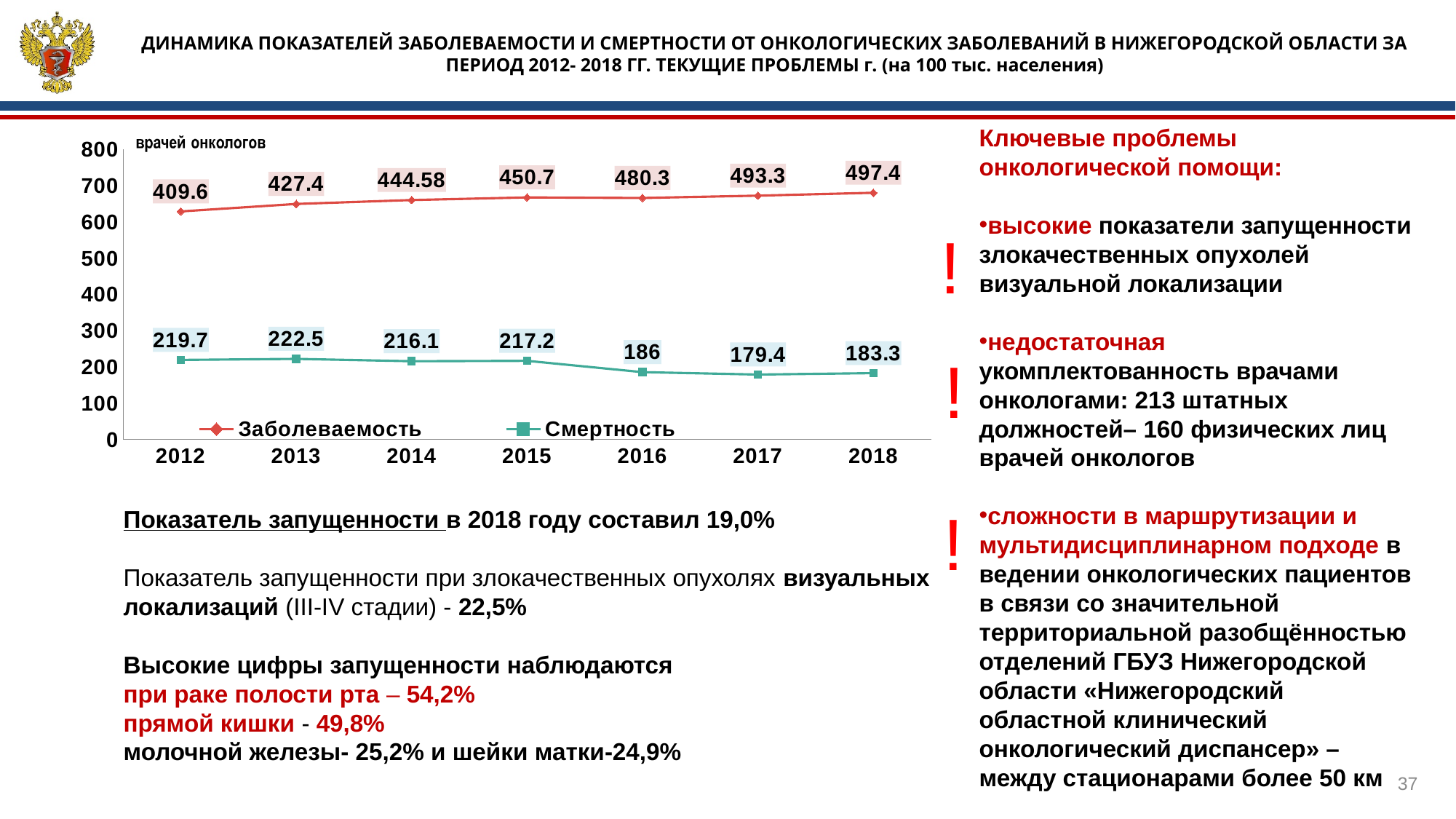
What is the difference between Заболеваемость in 2018 and in 2012? 87.8 Which is larger: Смертность in 2013 or Смертность in 2018? 2013 What type of chart is shown on the slide? line chart What are the two series named in the chart legend? Заболеваемость and Смертность Does Заболеваемость rise or fall from 2012 to 2018? rise How many series does the chart legend list? 2 How many years are shown on the x axis of the chart? 7 In which year is Смертность lowest? 2017 What is the value of Заболеваемость in 2014? 444.58 What is the value of Заболеваемость in 2012? 409.6 What is the value of Смертность in 2016? 186 In which year is Заболеваемость highest? 2018